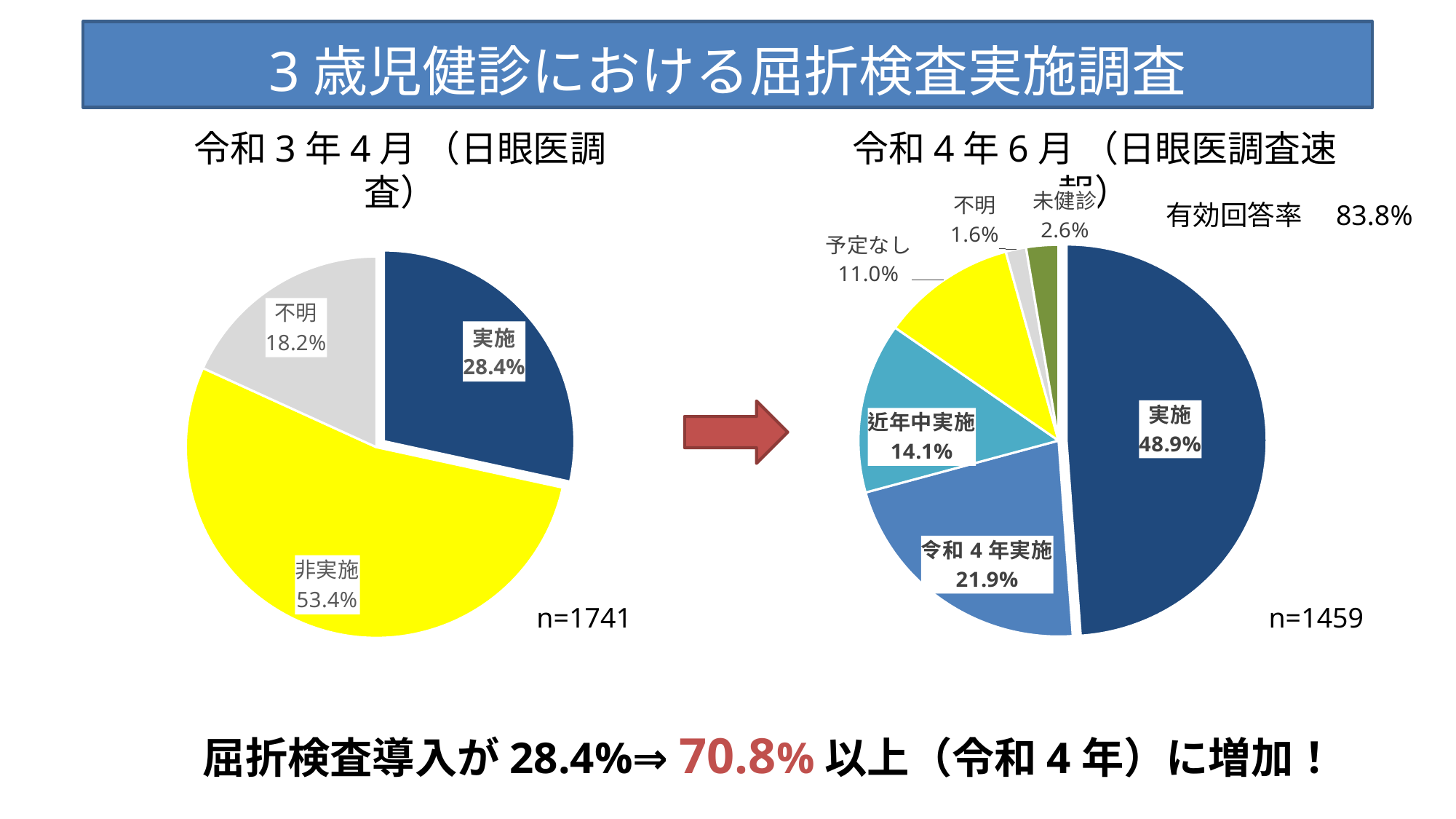
In the left pie chart (令和3年4月), which category has the largest share? 非実施 What is the difference between the 実施 share in the right pie chart (48.9%) and the 実施 share in the left pie chart (28.4%)? 20.5 percentage points What type of charts are shown on the slide? Pie charts In the left pie chart (令和3年4月), which category has the smallest share? 不明 In the left pie chart (令和3年4月), how many slices are there? 3 In the left pie chart (令和3年4月), what is the share for 非実施? 53.4% What is the sample size (n) shown for the right pie chart (令和4年6月)? n=1459 In the left pie chart (令和3年4月), what is the share for 実施? 28.4% In the right pie chart (令和4年6月), what is the share for 実施? 48.9% In the right pie chart (令和4年6月), which category has the smallest share? 不明 In the right pie chart (令和4年6月), how many slices are there? 6 In the right pie chart (令和4年6月), what is the share for 近年中実施? 14.1%